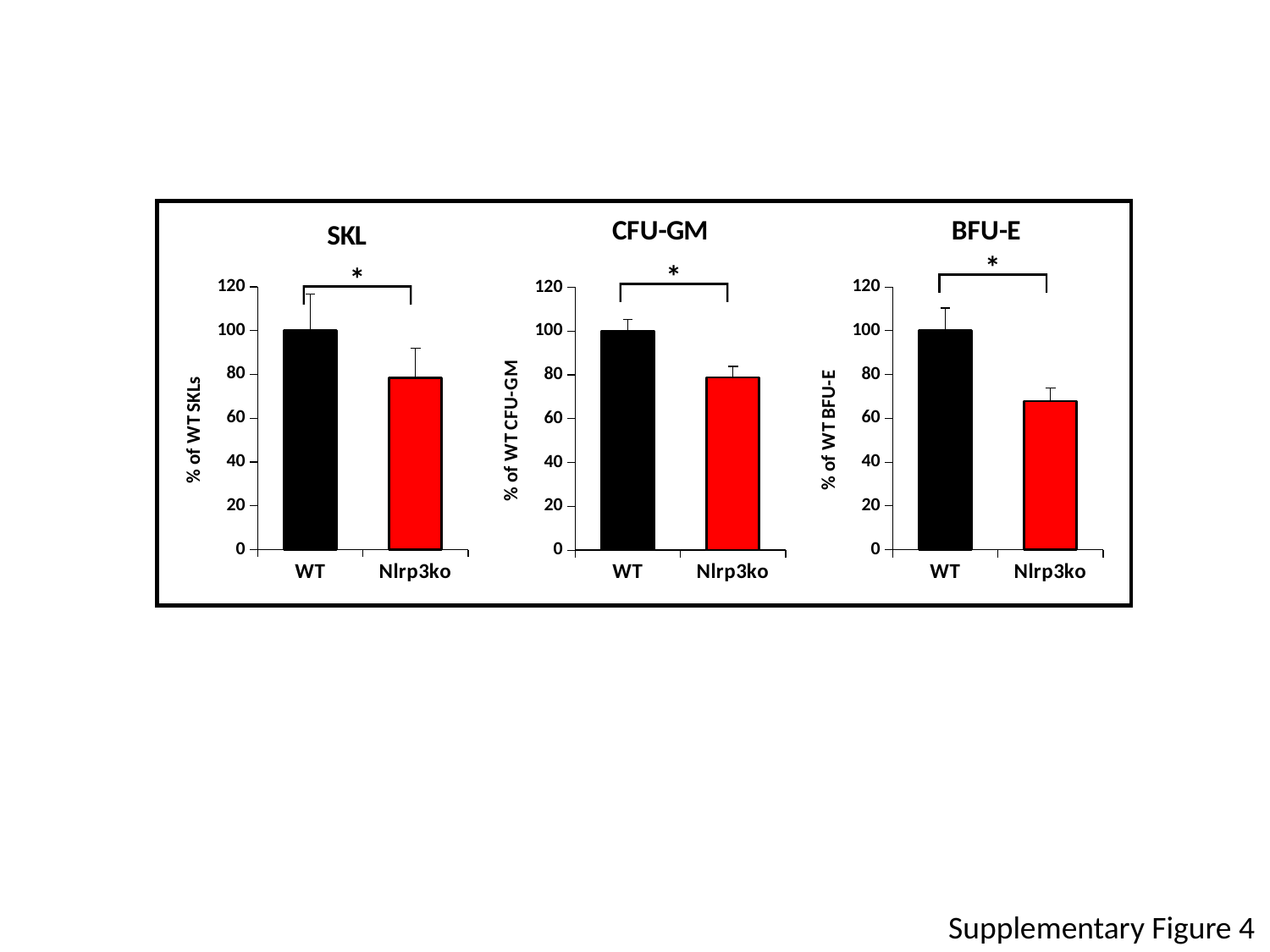
In the SKL chart, which is larger, the value for WT or the value for Nlrp3ko? WT In the BFU-E chart, is the value for Nlrp3ko greater or less than 80? less In the BFU-E chart, which category has the lowest value? Nlrp3ko In the SKL chart, what is the value for WT? 100 In the CFU-GM chart, which category has the highest value? WT In the SKL chart, is the value for Nlrp3ko greater or less than 100? less In the BFU-E chart, what is the value for WT? 100 In the CFU-GM chart, what is the value for WT? 100 In the CFU-GM chart, is the value for Nlrp3ko greater or less than 60? greater What is the y-axis label of the SKL chart? % of WT SKLs What kind of chart is the CFU-GM chart? bar chart How many categories are shown in the BFU-E chart? 2